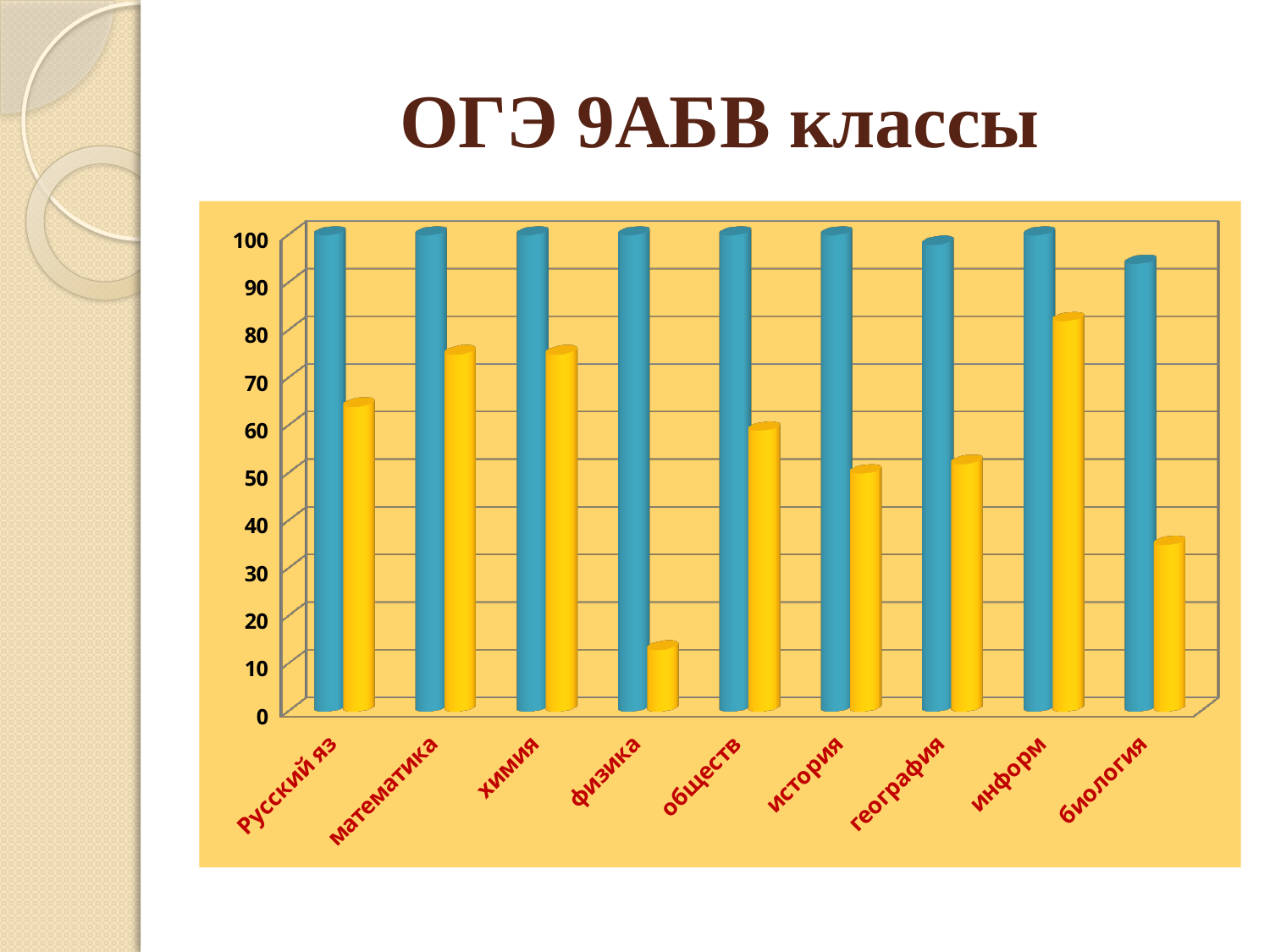
Is the value of the yellow bar for физика greater or less than 20? less Which category has the highest yellow bar? информ Is the value of the blue bar for биология greater or less than 90? greater Which has the larger yellow bar, математика or история? математика What two colours are used for the bars in the chart? blue and yellow Which category has the lowest blue bar? биология Is the value of the yellow bar for биология greater or less than 50? less Which category has the lowest yellow bar? физика What is the title of the chart? ОГЭ 9АБВ классы What kind of chart is shown on the slide? bar chart How many categories are shown on the x axis of the chart? 9